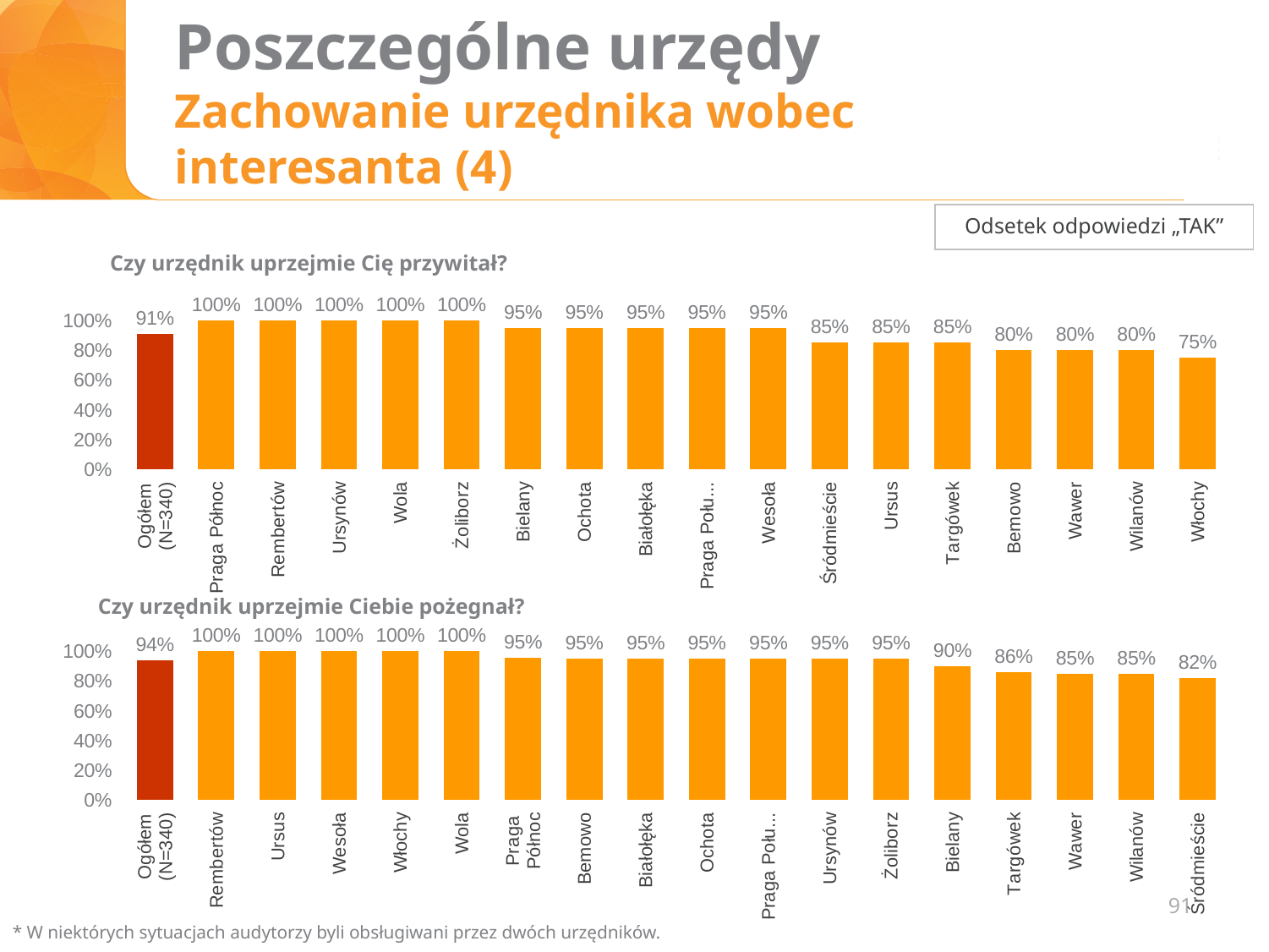
In the bottom chart ("Czy urzędnik uprzejmie Ciebie pożegnał?"), what is the value for Ogółem (N=340)? 94% In the bottom chart ("Czy urzędnik uprzejmie Ciebie pożegnał?"), which category has the lowest value? Śródmieście In the bottom chart ("Czy urzędnik uprzejmie Ciebie pożegnał?"), what is the difference between the values for Ursus and Śródmieście? 18 percentage points In the top chart ("Czy urzędnik uprzejmie Cię przywitał?"), which category has the lowest value? Włochy What type of chart is used for "Czy urzędnik uprzejmie Cię przywitał?"? Bar chart In the top chart ("Czy urzędnik uprzejmie Cię przywitał?"), what is the value for Włochy? 75% In the top chart ("Czy urzędnik uprzejmie Cię przywitał?"), what is the difference between the values for Bielany and Bemowo? 15 percentage points In the bottom chart ("Czy urzędnik uprzejmie Ciebie pożegnał?"), what is the value for Targówek? 86% In the top chart ("Czy urzędnik uprzejmie Cię przywitał?"), do the values rise or fall from left to right after the Ogółem bar? Fall In the top chart ("Czy urzędnik uprzejmie Cię przywitał?"), how many bars are plotted? 18 In the bottom chart ("Czy urzędnik uprzejmie Ciebie pożegnał?"), which is larger, the value for Bielany or the value for Wawer? Bielany In the top chart ("Czy urzędnik uprzejmie Cię przywitał?"), what is the value for Ogółem (N=340)? 91%